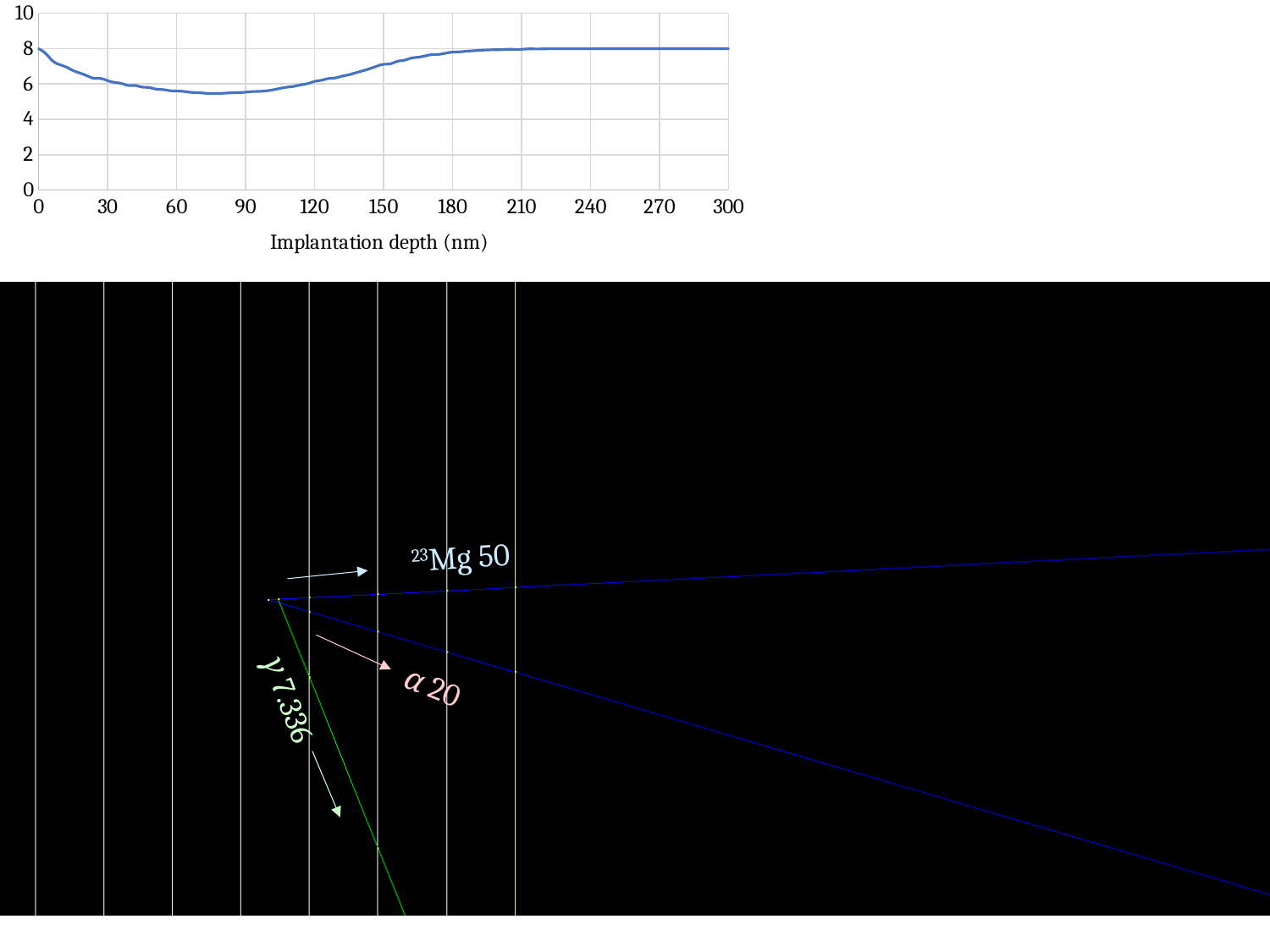
In the top chart, is the value at 240 nm larger or smaller than the value at 90 nm? larger What kind of chart is shown at the top of the slide? line chart In the top chart, is the value at an implantation depth of 150 nm greater or less than 6? greater In the top chart, what is the title of the x axis? Implantation depth (nm) In the top chart, is the value at an implantation depth of 150 nm greater or less than 8? less In the top chart, is the value at an implantation depth of 90 nm greater or less than 6? less In the top chart, does the line rise or fall between implantation depths of 0 nm and 60 nm? fall In the top chart, does the line rise or fall between implantation depths of 120 nm and 180 nm? rise In the top chart, how many lines (series) are plotted? 1 In the top chart, what is the highest value shown on the x axis? 300